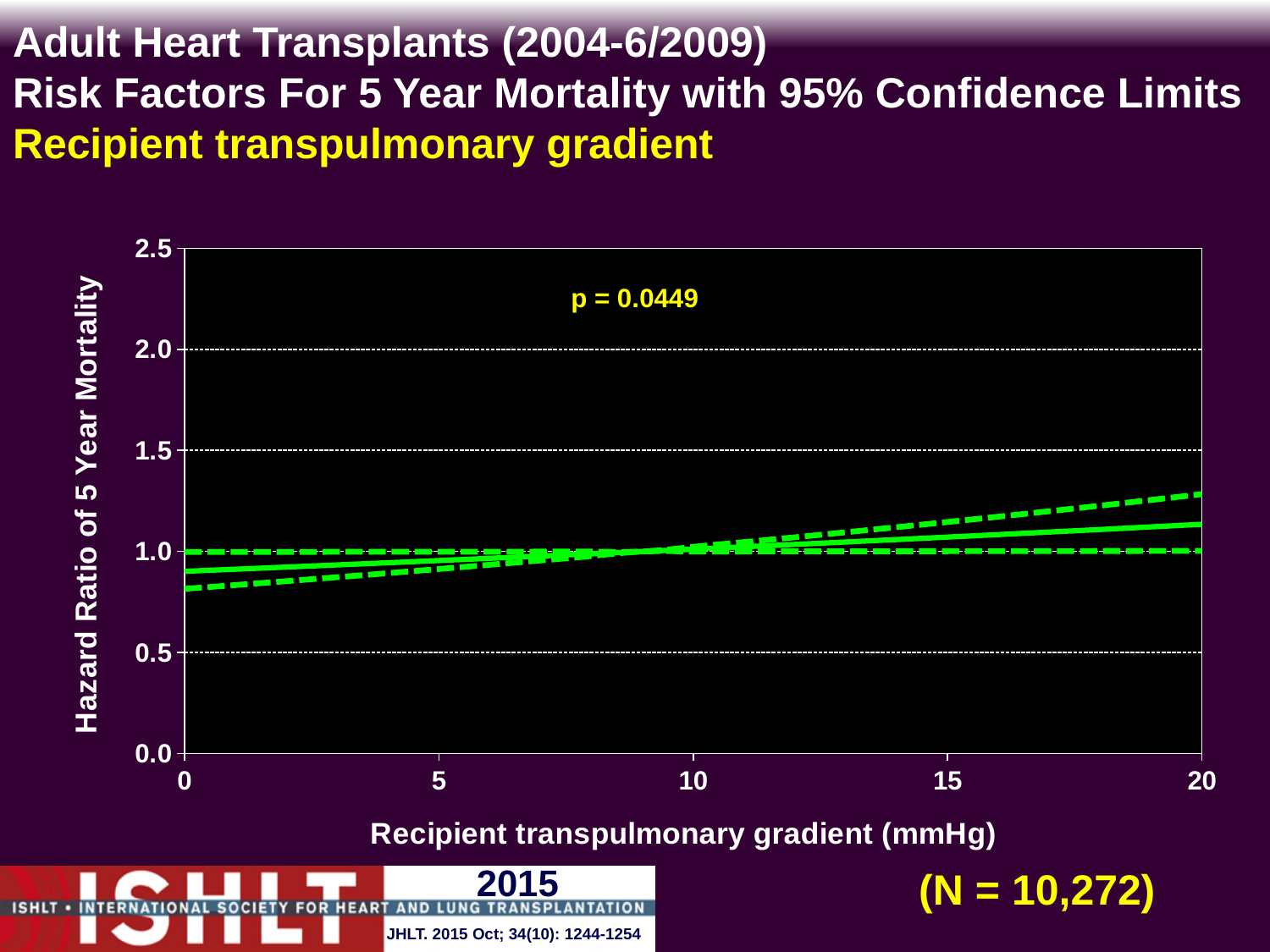
Is the lower 95% confidence limit at a recipient transpulmonary gradient of 0 mmHg greater or less than 0.5? greater Is the hazard ratio (solid line) at a recipient transpulmonary gradient of 20 mmHg greater or less than 1.0? greater Does the hazard ratio of 5 year mortality rise or fall as recipient transpulmonary gradient increases from 0 to 20 mmHg? rise What p-value is printed on the chart? p = 0.0449 What is the highest value shown on the y axis of the chart? 2.5 How many lines are plotted on the chart (the estimate plus its confidence limits)? 3 Is the hazard ratio (solid line) at a recipient transpulmonary gradient of 0 mmHg greater or less than 1.0? less What kind of chart is shown on the slide? line chart At which end of the x axis, 0 mmHg or 20 mmHg, is the hazard ratio (solid line) higher? 20 mmHg What sample size (N) is printed on the slide? N = 10,272